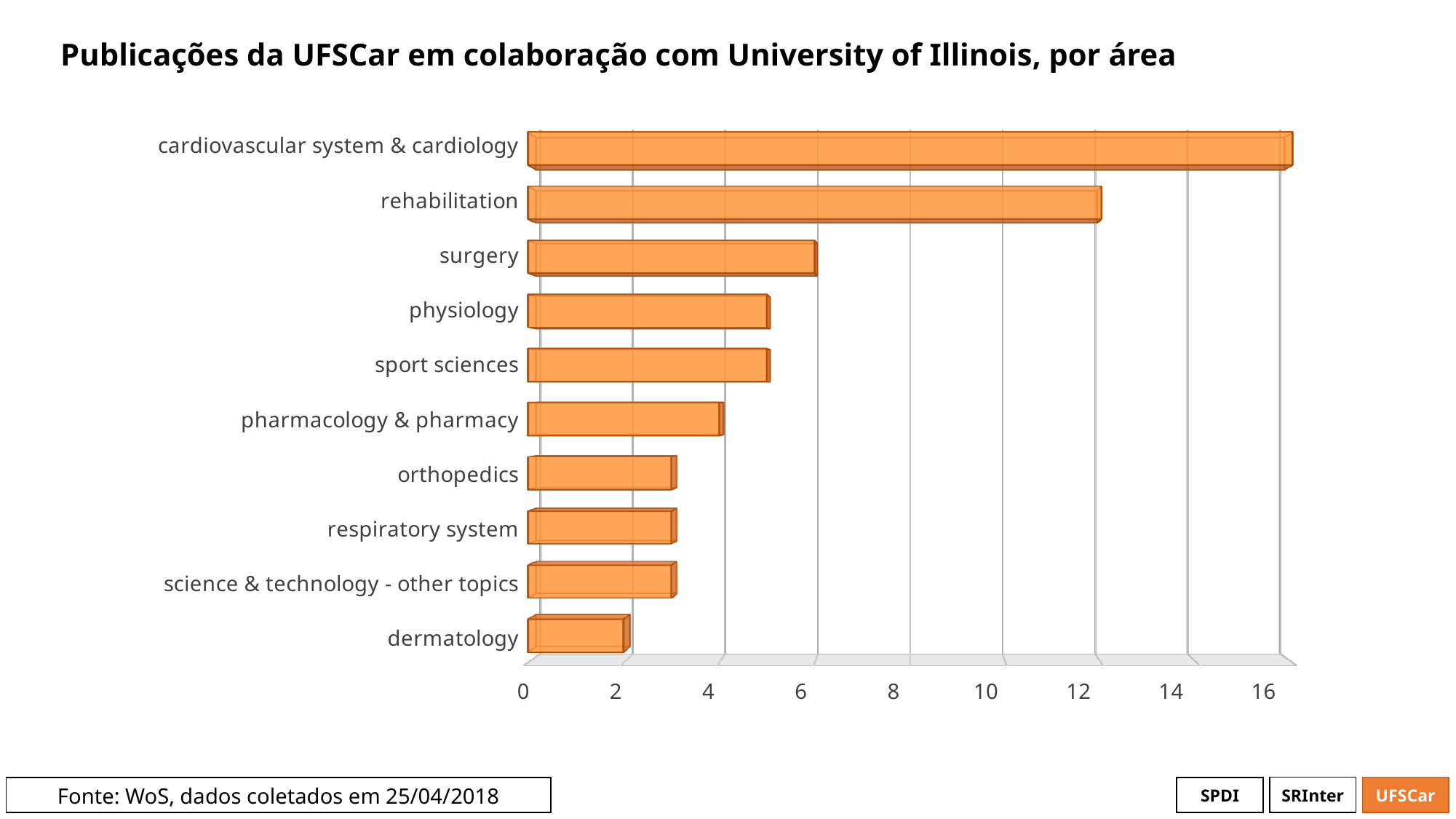
What kind of chart is shown on the slide? bar chart Is the value for dermatology greater or less than 4? less How many areas (categories) are shown in the chart? 10 Is the value for rehabilitation greater or less than 10? greater Is the value for pharmacology & pharmacy greater or less than 6? less What is the title of the chart? Publicações da UFSCar em colaboração com University of Illinois, por área Which has more publications, orthopedics or physiology? physiology Which has more publications, rehabilitation or surgery? rehabilitation Which area has the lowest number of publications? dermatology Which area has the highest number of publications? cardiovascular system & cardiology